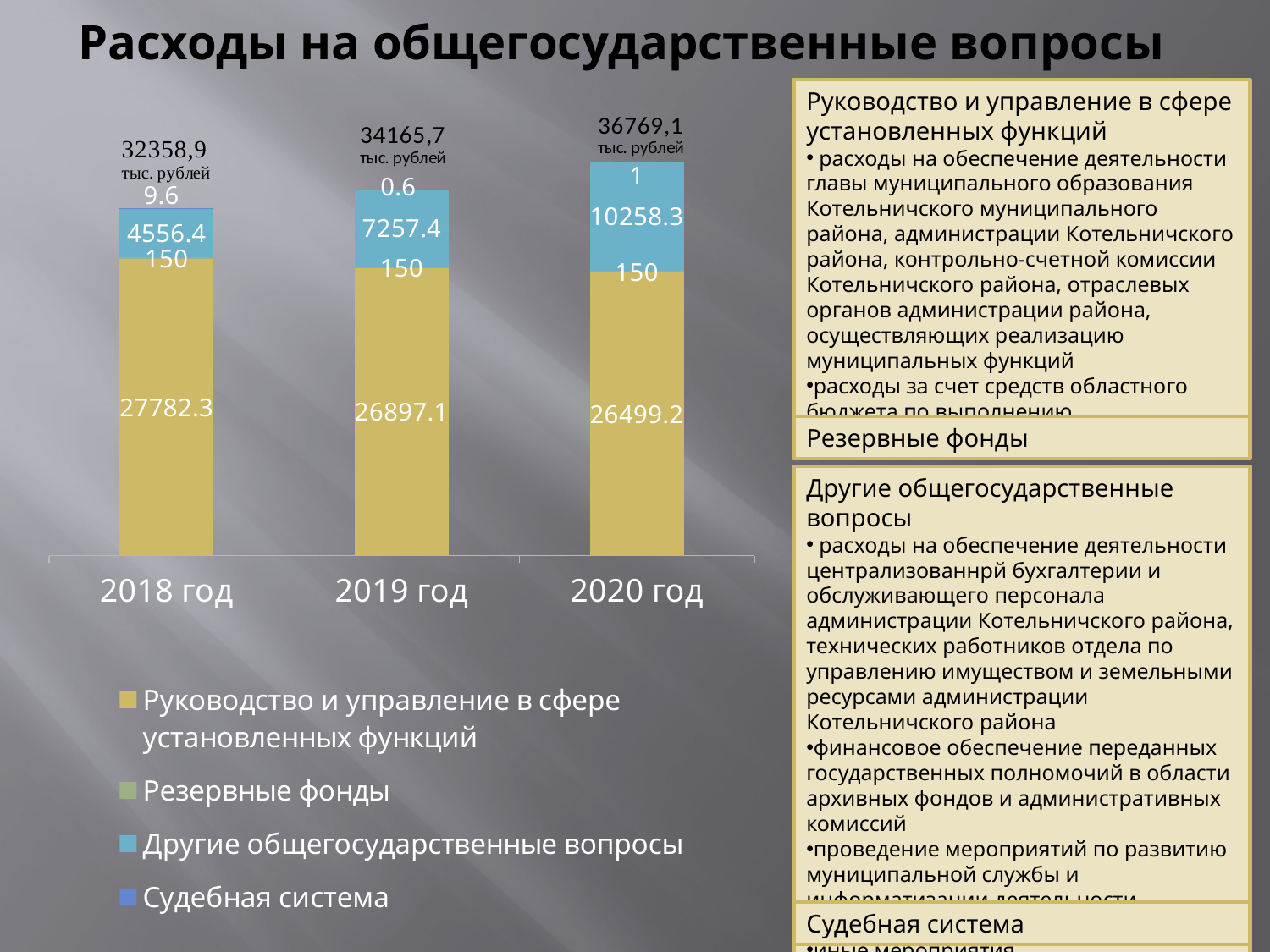
Does the total expenditure rise or fall from 2018 год to 2020 год? rise What kind of chart is shown on the slide? stacked bar chart In which year is the value for Другие общегосударственные вопросы the highest? 2020 год In which year is the value for Руководство и управление в сфере установленных функций the lowest? 2020 год What is the difference between the Другие общегосударственные вопросы values for 2019 год and 2018 год? 2701 What is the value for Другие общегосударственные вопросы in 2020 год? 10258.3 How many years (categories) are shown on the x axis? 3 How many series does the legend list? 4 What is the value for Резервные фонды in 2020 год? 150 What is the value for Руководство и управление в сфере установленных функций in 2018 год? 27782.3 What is the value for Судебная система in 2019 год? 0.6 What is the total shown above the bar for 2020 год? 36769,1 тыс. рублей